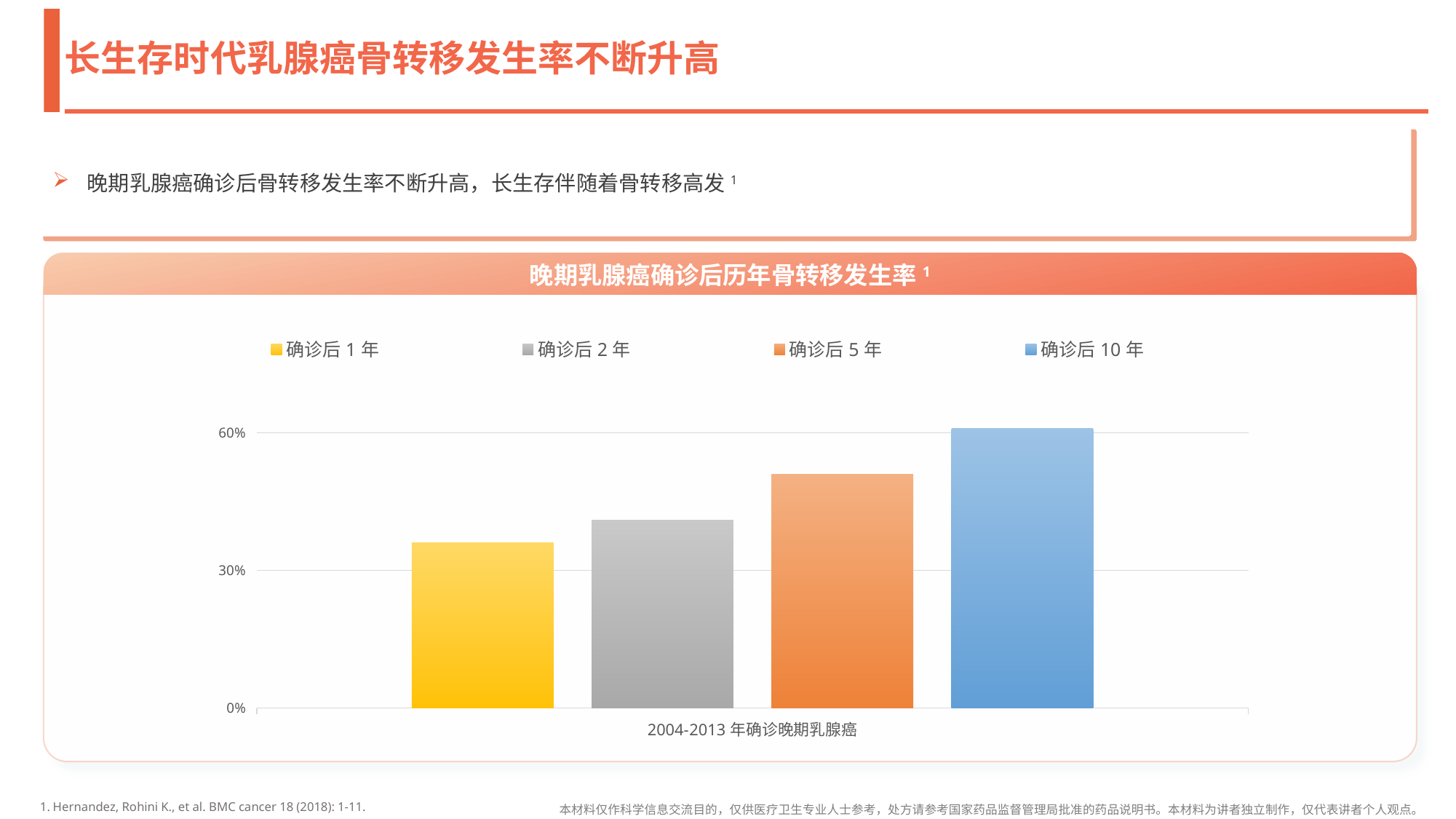
Do the bars rise or fall as the time since diagnosis increases from 1 year to 10 years? rise How many series does the legend list? 4 Is the value for 确诊后 5 年 greater or less than 30%? greater Is the value for 确诊后 1 年 greater or less than 60%? less Is the value for 确诊后 5 年 greater or less than 60%? less What kind of chart is shown on the slide? bar chart Which is larger, the value for 确诊后 2 年 or the value for 确诊后 5 年? 确诊后 5 年 How many categories are shown on the x axis? 1 Which series has the lowest bone metastasis rate? 确诊后 1 年 What is the title of the chart? 晚期乳腺癌确诊后历年骨转移发生率 What colour is the bar for 确诊后 10 年? blue Which series has the highest bone metastasis rate? 确诊后 10 年